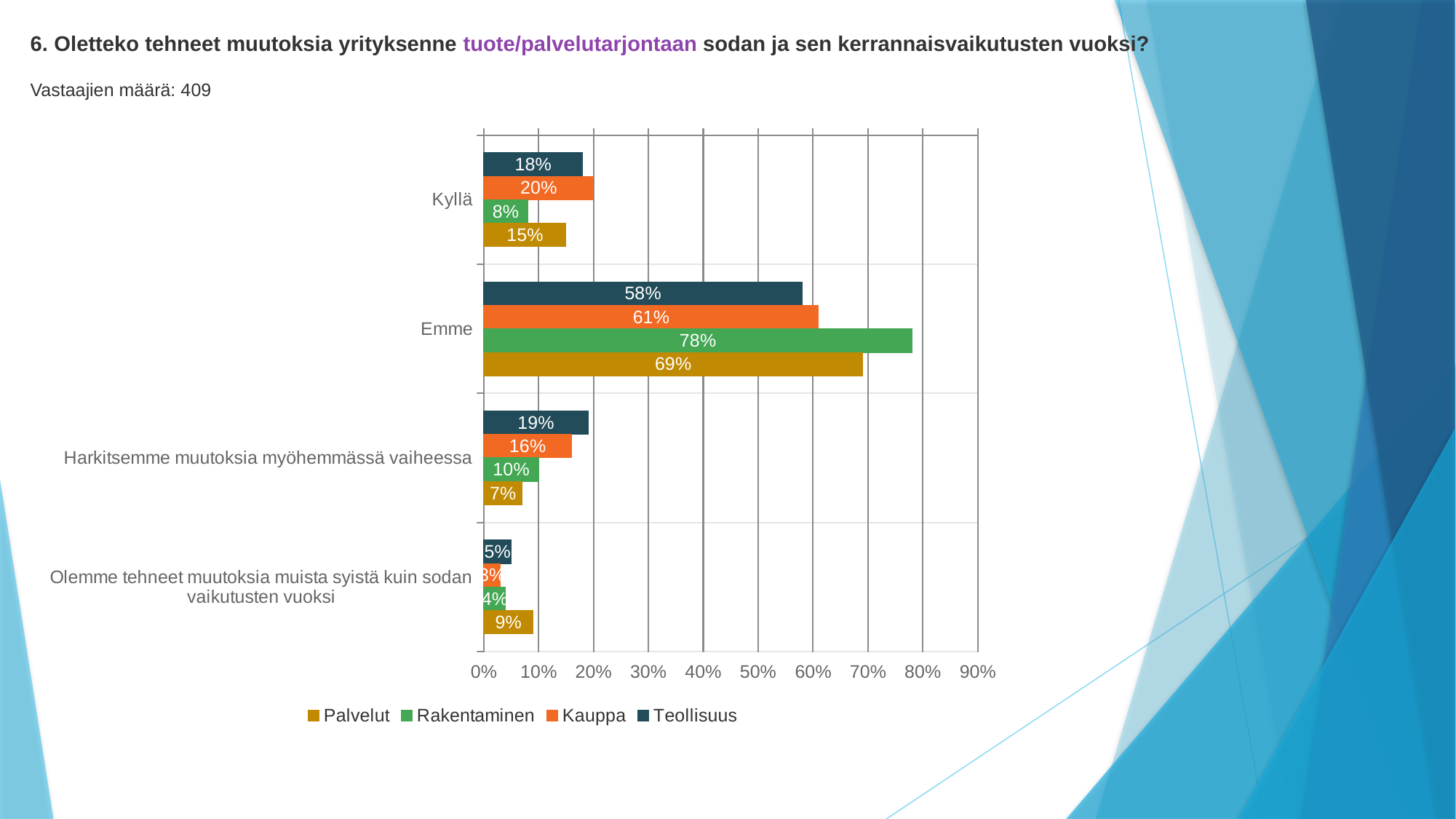
Which series has the highest value in the Emme category? Rakentaminen In the Harkitsemme muutoksia myöhemmässä vaiheessa category, which is larger: Teollisuus or Kauppa? Teollisuus Which series has the lowest value in the Kyllä category? Rakentaminen Which series is shown in green in the legend? Rakentaminen What is the value for Kauppa in the Kyllä category? 20% How many series does the legend list? 4 What is the value for Teollisuus in the Emme category? 58% What is the difference between the Palvelut and Teollisuus values in the Emme category? 11% What kind of chart is shown on the slide? bar chart What is the value for Rakentaminen in the Emme category? 78% What is the value for Palvelut in the Harkitsemme muutoksia myöhemmässä vaiheessa category? 7% How many response categories are shown on the chart? 4